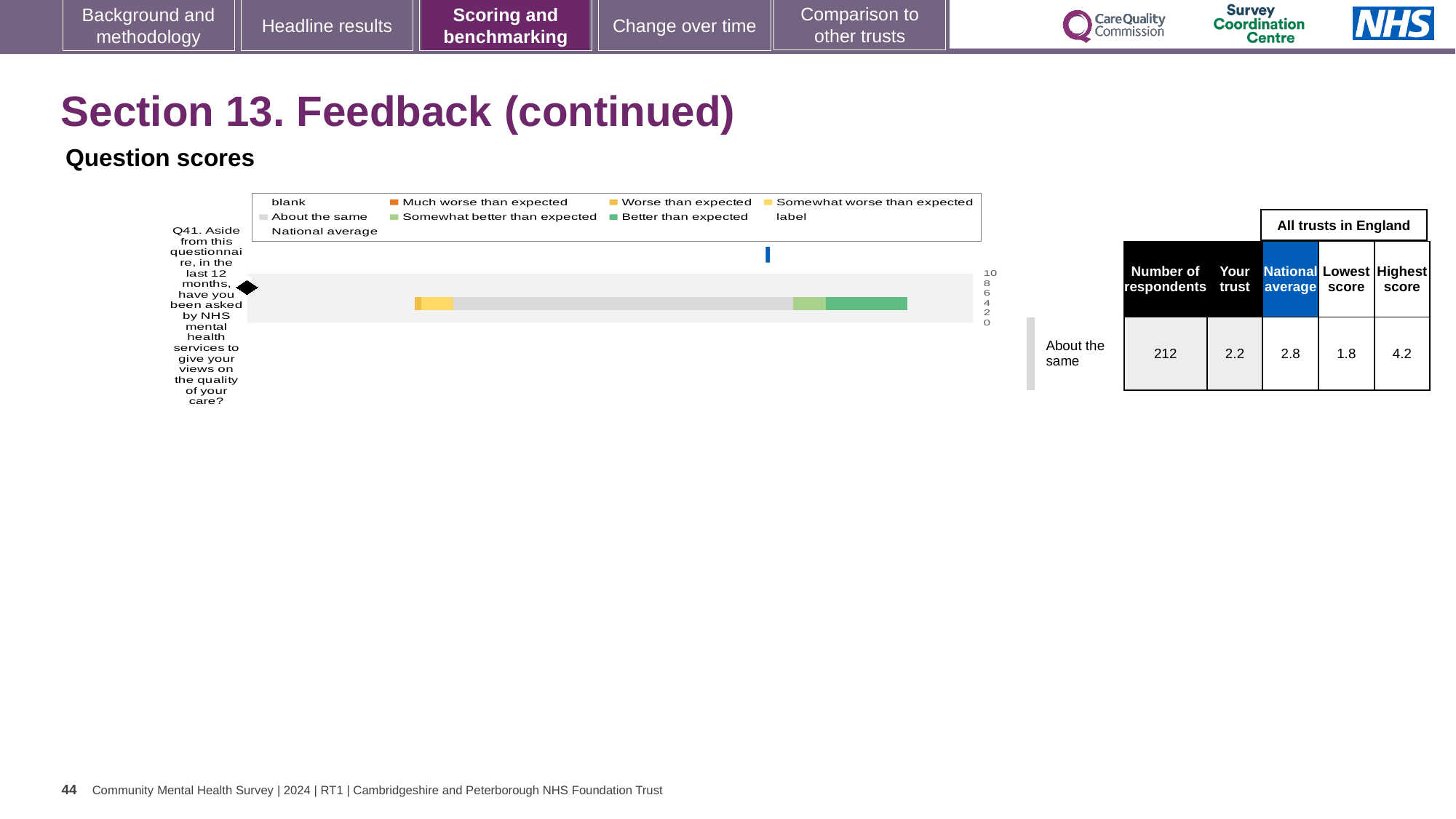
What is the lowest score among all trusts in England for Q41? 1.8 What benchmark category is shown next to the Q41 bar? About the same How many survey questions are plotted in the question scores chart? 1 What kind of chart is used to show the Q41 question score? bar chart What is the highest score among all trusts in England for Q41? 4.2 What is the 'Your trust' score for Q41? 2.2 How many respondents answered Q41? 212 What is the difference between the national average and the 'Your trust' score for Q41? 0.6 What is the national average score for Q41? 2.8 What is the difference between the highest and lowest trust scores for Q41? 2.4 Which is larger for Q41, the 'Your trust' score or the national average? National average Which question number is plotted in the question scores chart? Q41